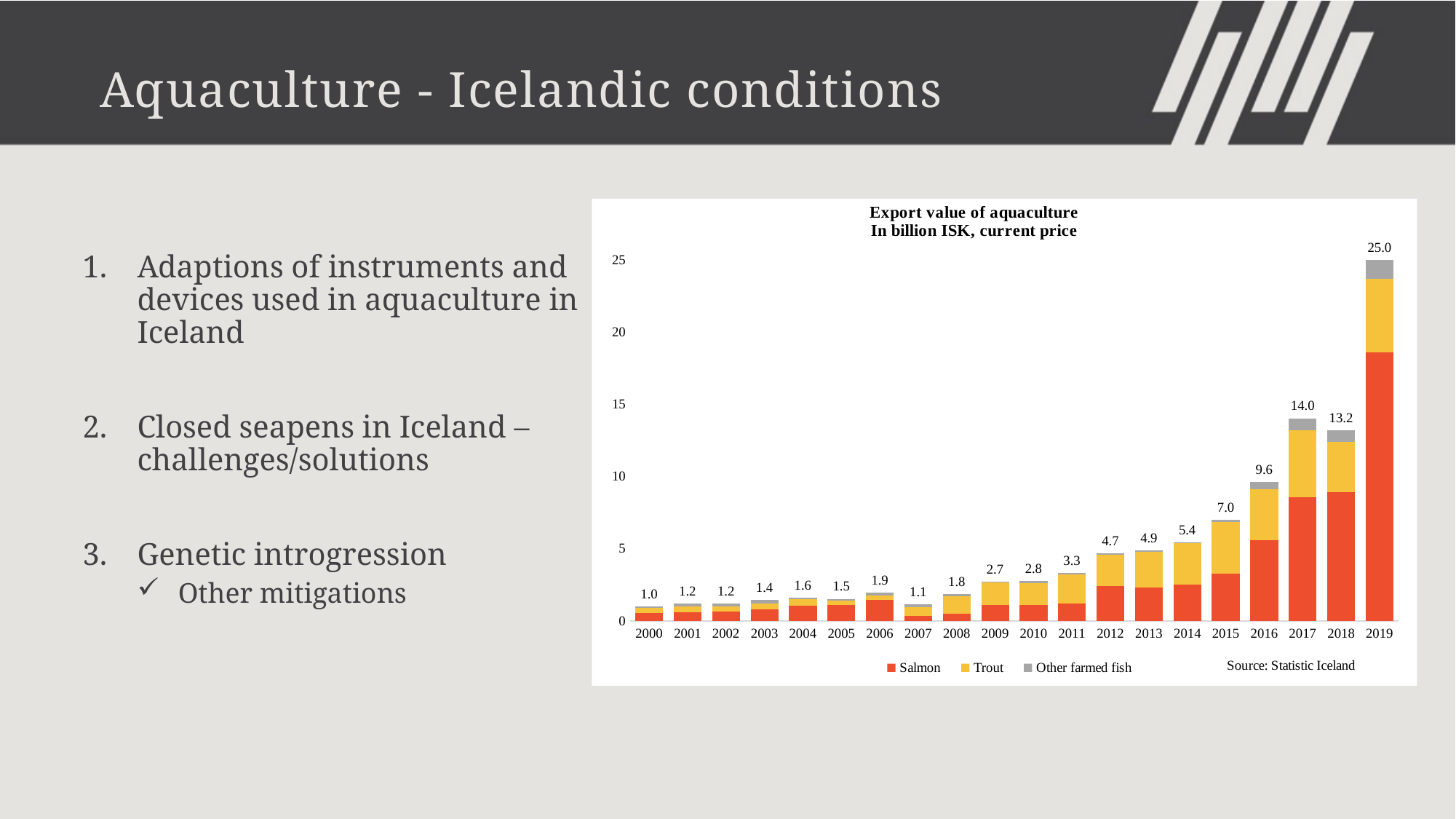
What is the total export value of aquaculture shown for 2017? 14.0 What is the source cited for the chart data? Statistic Iceland Is the Salmon value for 2019 greater or less than 15? greater What is the difference between the total export values for 2019 and 2018? 11.8 How many series does the chart legend list? 3 What is the total export value of aquaculture shown for 2012? 4.7 Which year has the highest total export value of aquaculture? 2019 How many years are shown on the x axis of the chart? 20 What is the total export value of aquaculture shown for 2019? 25.0 Which year has the lowest total export value of aquaculture? 2000 Which year has a larger total export value, 2017 or 2018? 2017 What kind of chart is used to show the export value of aquaculture? Stacked bar chart